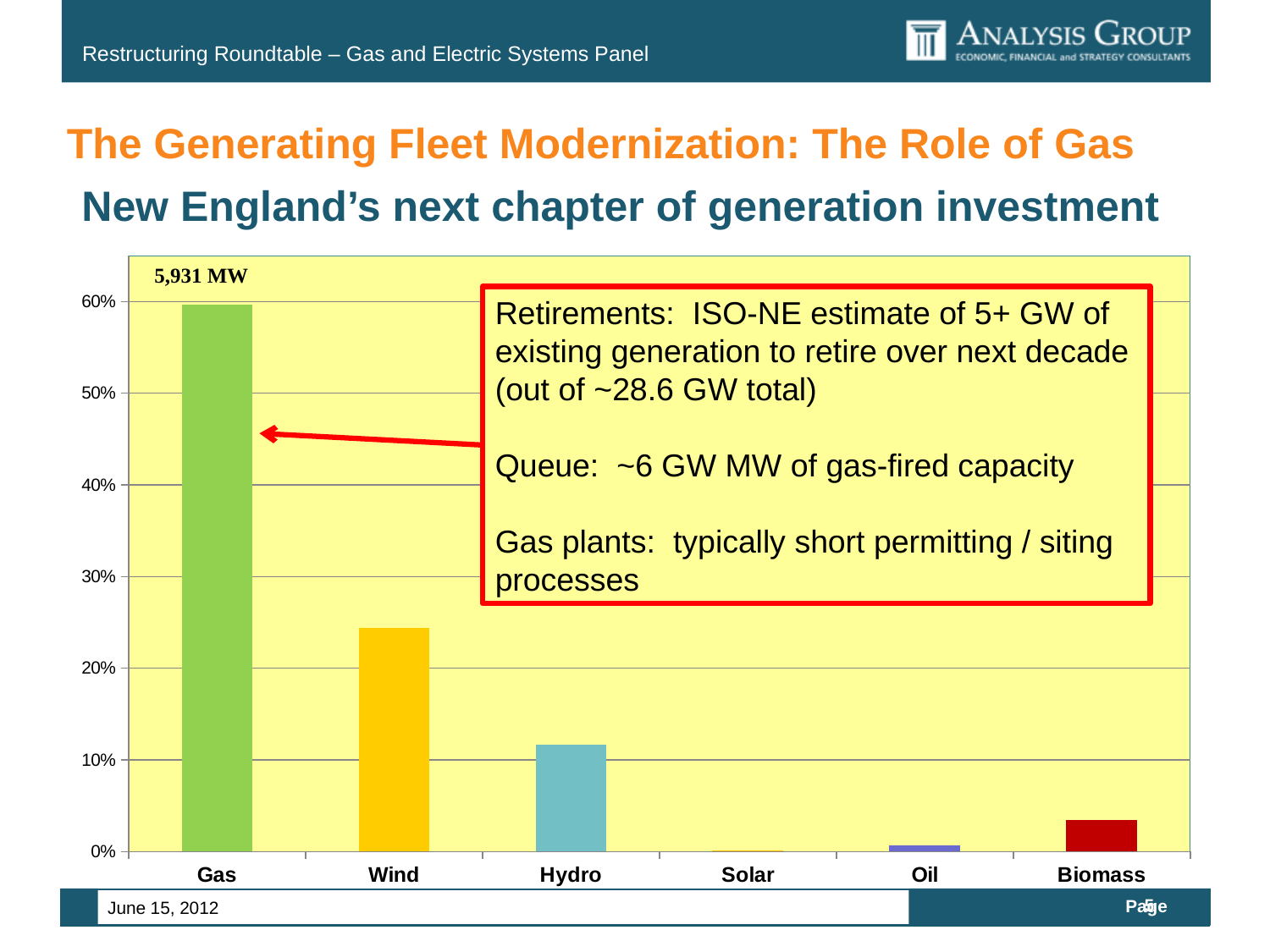
What data label is printed above the Gas bar? 5,931 MW Is the value for Wind greater or less than 30%? less What is the highest percentage tick shown on the y axis of the chart? 60% How many categories are shown on the x axis of the chart? 6 Is the value for Biomass greater or less than 10%? less What type of chart is shown on the slide? bar chart Is the value for Wind greater or less than 20%? greater Which category has the highest bar in the chart? Gas Which is larger, the value for Wind or the value for Hydro? Wind Which is larger, the value for Biomass or the value for Oil? Biomass